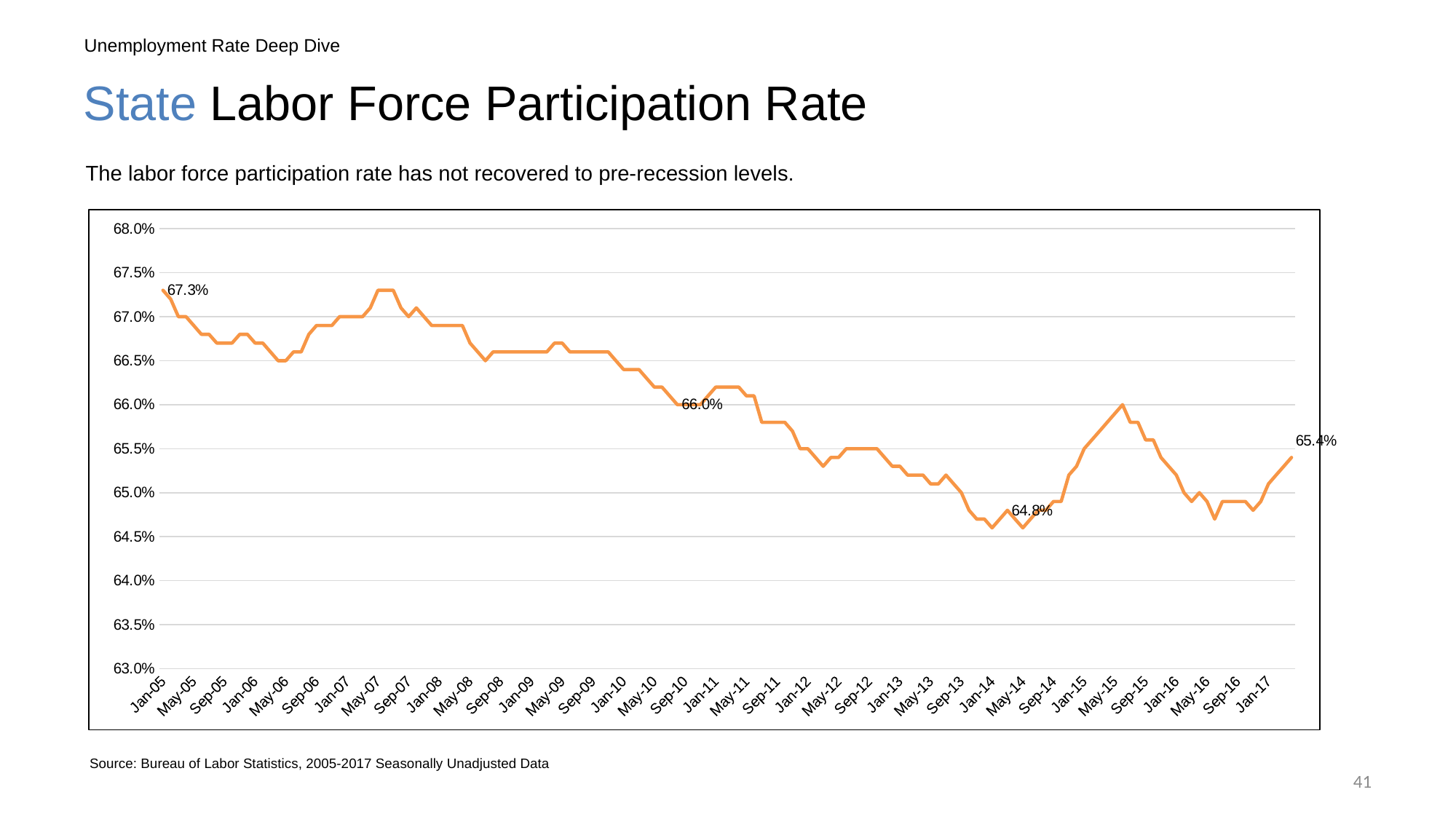
Which is larger: the labeled value at Jan-05 or the labeled value at the end of the line in 2017? Jan-05 What is the difference between the labeled values at Sep-10 (66.0%) and May-14 (64.8%)? 1.2 percentage points Is the value for Jan-14 greater or less than 65.0%? less What value is labeled on the line at Sep-10? 66.0% What is the labor force participation rate shown for Jan-05? 67.3% What is the range of the y axis on the chart? 63.0% to 68.0% What kind of chart is shown on the slide? line chart What is the value labeled at the final point of the line, in 2017? 65.4% By how many percentage points is the Jan-05 value (67.3%) higher than the final labeled value (65.4%)? 1.9 percentage points What value is labeled on the line at May-14? 64.8% Is the value for May-07 greater or less than 67.0%? greater Overall, does the labor force participation rate rise or fall from Jan-05 to 2017? fall